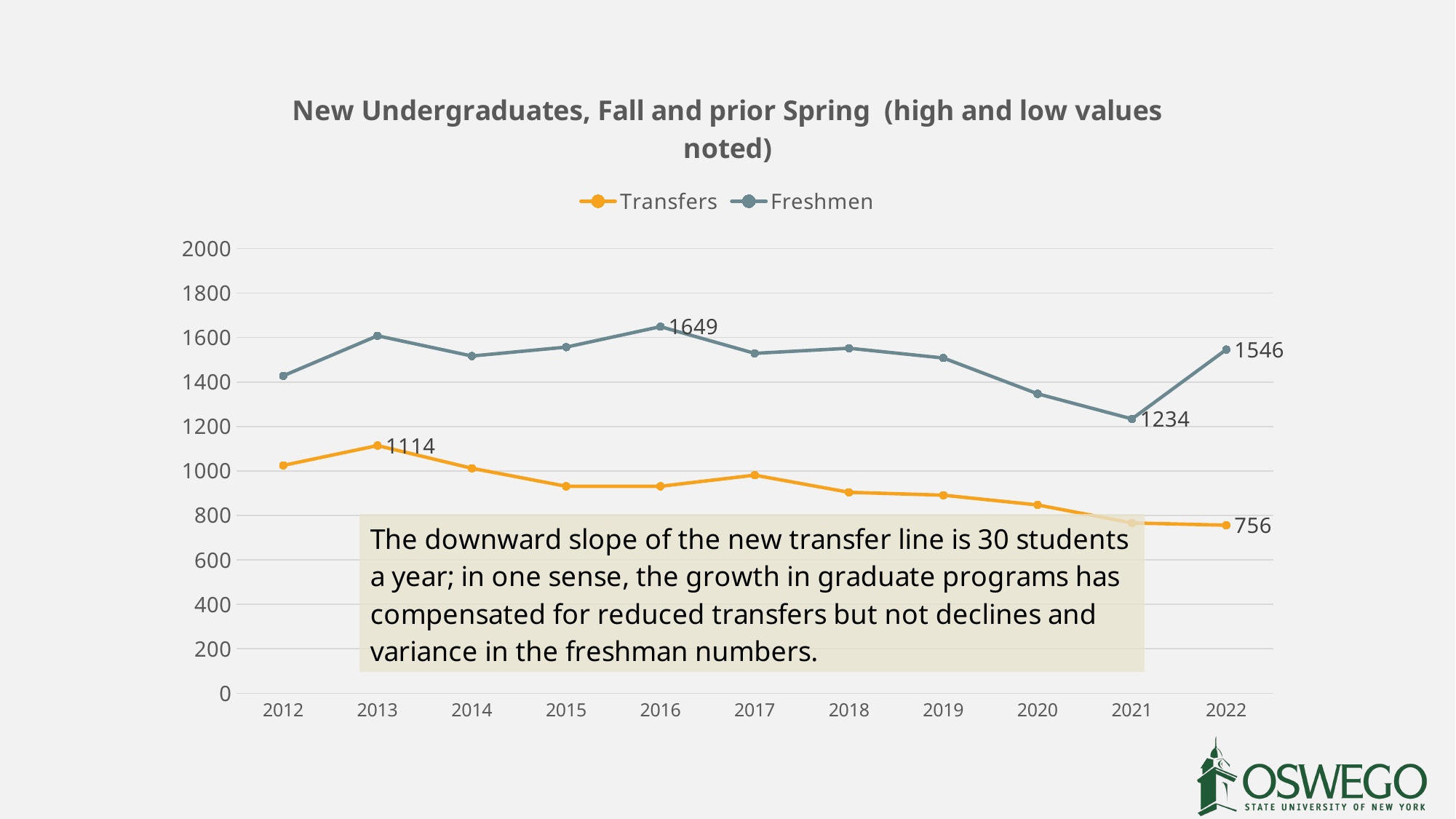
Is the Transfers value for 2018 greater or less than 1000? less Which series is shown in orange? Transfers What is the Transfers value for 2022? 756 What kind of chart is shown on the slide? Line chart In which year is the Transfers series at its lowest? 2022 How many years are plotted along the x axis? 11 What is the difference between the Freshmen value in 2016 and the Freshmen value in 2021? 415 What is the Transfers value for 2013? 1114 In which year is the Freshmen series at its highest? 2016 What is the Freshmen value for 2021? 1234 What is the Freshmen value for 2016? 1649 How many series does the legend list? 2